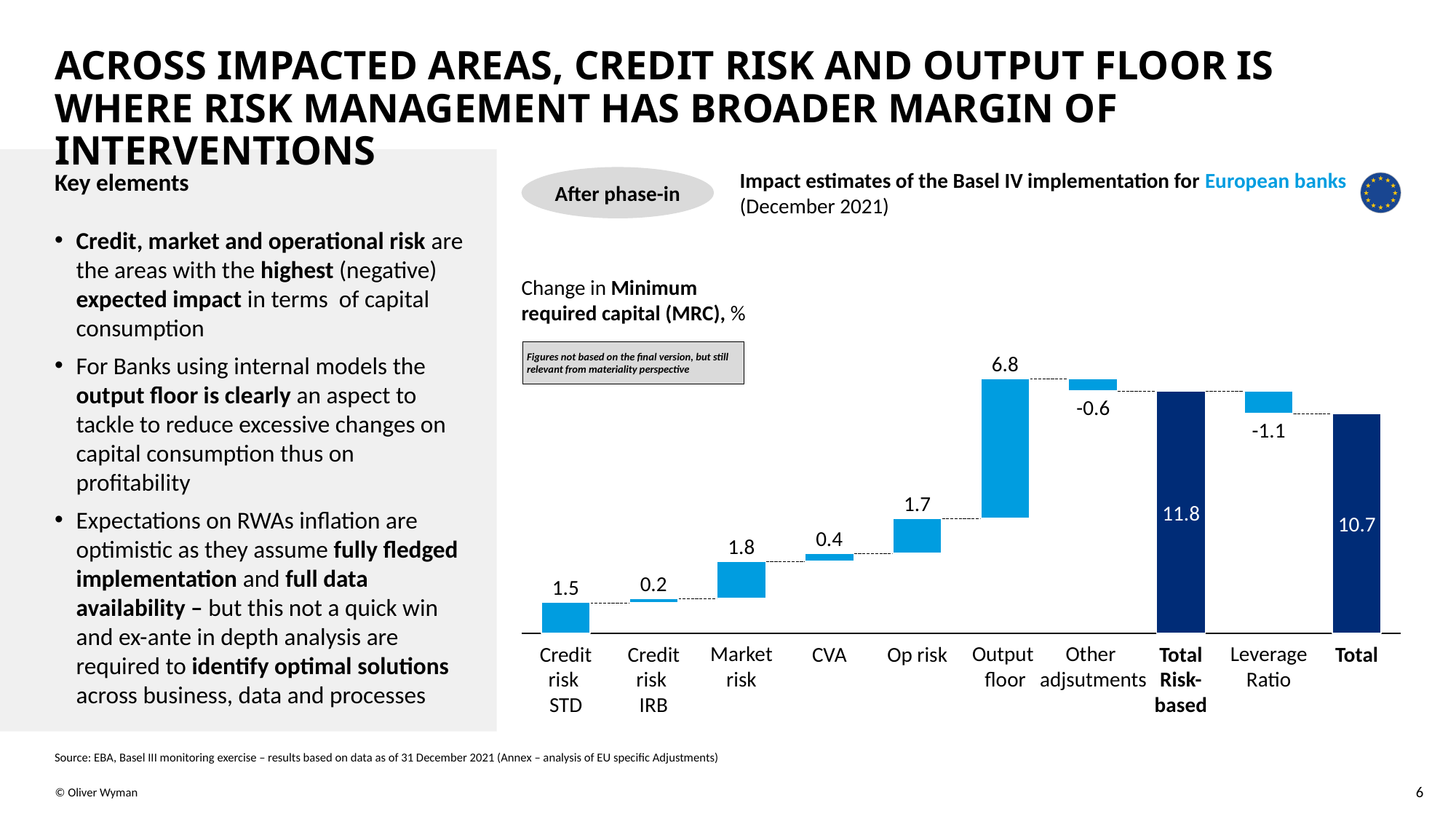
What is the difference between the Total Risk-based value and the final Total value? 1.1 What is the value shown for Market risk? 1.8 How many categories are shown along the x axis of the chart? 10 What is the value shown for Total Risk-based? 11.8 What is the difference between the Output floor value and the Op risk value? 5.1 What kind of chart is shown on the slide? Waterfall bar chart What is the value shown for Other adjustments? -0.6 Which individual component (excluding the totals) has the highest value? Output floor What is the value shown for Leverage Ratio? -1.1 What is the value shown for Output floor? 6.8 Which category has the lowest value in the chart? Leverage Ratio Which is larger, the value for Credit risk STD or the value for Credit risk IRB? Credit risk STD